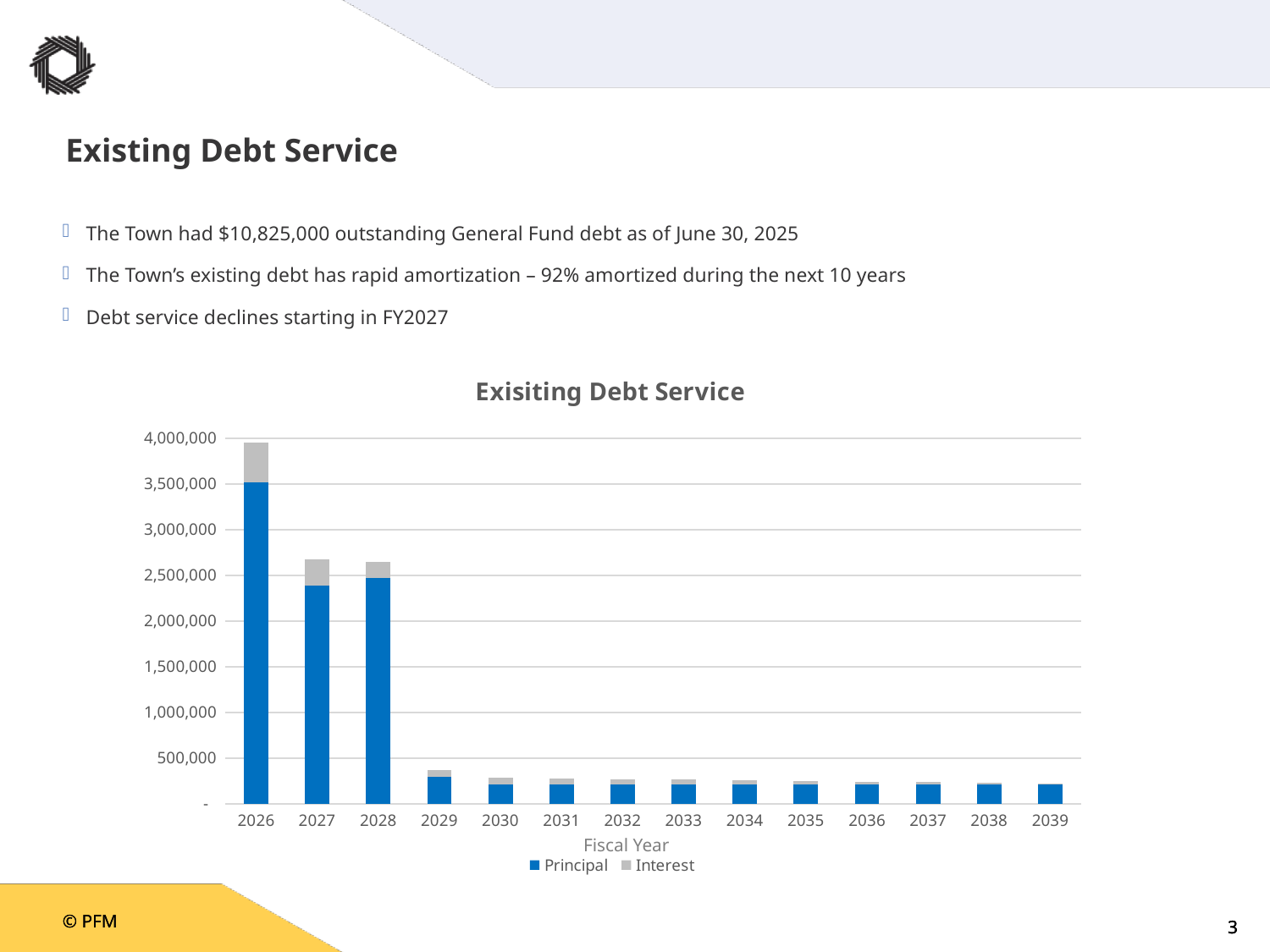
Do the total debt service values generally rise or fall from 2026 to 2039? fall What is the label of the x axis of the chart? Fiscal Year Which fiscal year has the larger total debt service, 2028 or 2029? 2028 How many fiscal years are shown on the x axis of the chart? 14 Is the total debt service for 2029 greater or less than 500,000? less How many series does the chart's legend list? 2 Which fiscal year has the highest total debt service in the chart? 2026 Is the Principal value for 2027 greater or less than 2,500,000? less What kind of chart is shown on the slide? Stacked bar chart Which fiscal year has the larger total debt service, 2026 or 2027? 2026 Is the total debt service for 2027 greater or less than 2,500,000? greater